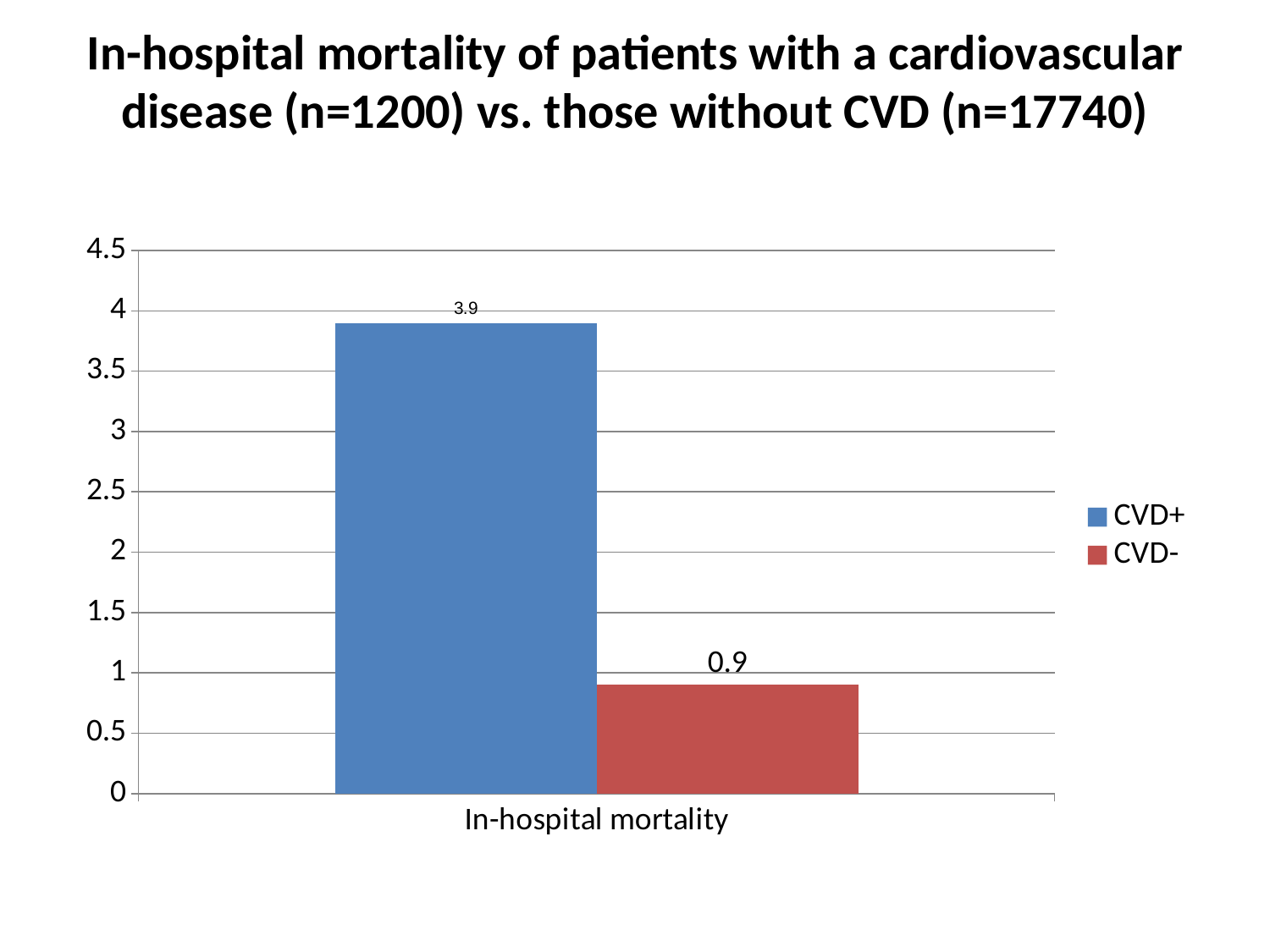
What is the difference between the CVD+ and CVD- in-hospital mortality values? 3 Which series has the lowest in-hospital mortality? CVD- What is the category label on the x axis? In-hospital mortality What is the in-hospital mortality value for CVD-? 0.9 Is the value for CVD+ greater or less than 3? greater How many series does the legend list? 2 Is the value for CVD- greater or less than 1? less What colour is the bar for CVD-? red What is the highest value shown on the y axis? 4.5 What kind of chart is shown on the slide? bar chart Which series has the higher in-hospital mortality, CVD+ or CVD-? CVD+ What is the in-hospital mortality value for CVD+? 3.9